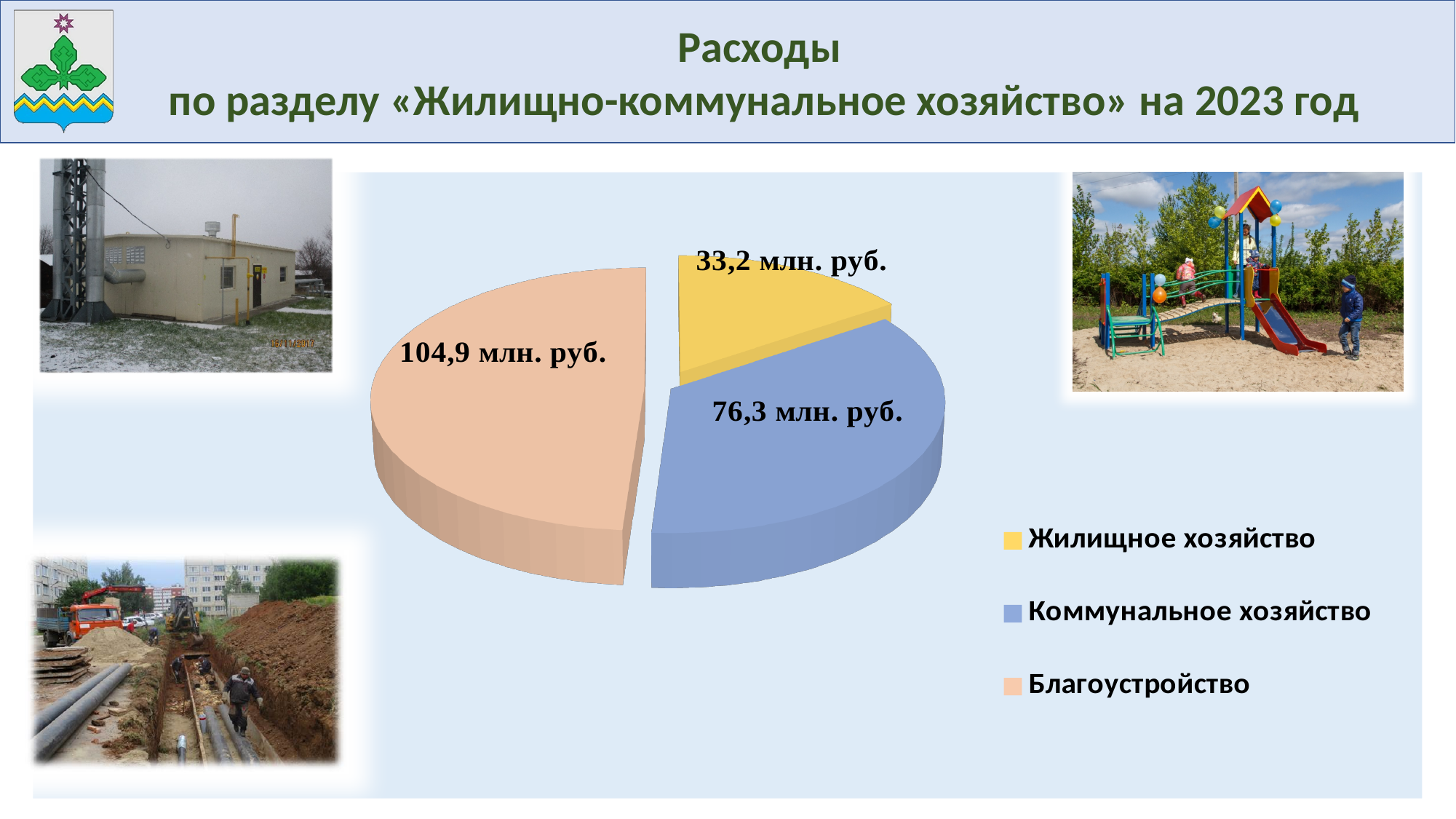
What kind of chart is shown on the slide? Pie chart What is the difference between Благоустройство and Коммунальное хозяйство? 28,6 млн. руб. How many entries does the legend list? 3 What is the value for Коммунальное хозяйство? 76,3 млн. руб. Which category has the smallest value? Жилищное хозяйство What colour is the slice for Благоустройство? Peach (light orange) What is the difference between Коммунальное хозяйство and Жилищное хозяйство? 43,1 млн. руб. Which is larger, Коммунальное хозяйство or Жилищное хозяйство? Коммунальное хозяйство What is the value for Благоустройство? 104,9 млн. руб. How many slices does the pie chart have? 3 Which category has the largest value? Благоустройство What is the value for Жилищное хозяйство? 33,2 млн. руб.